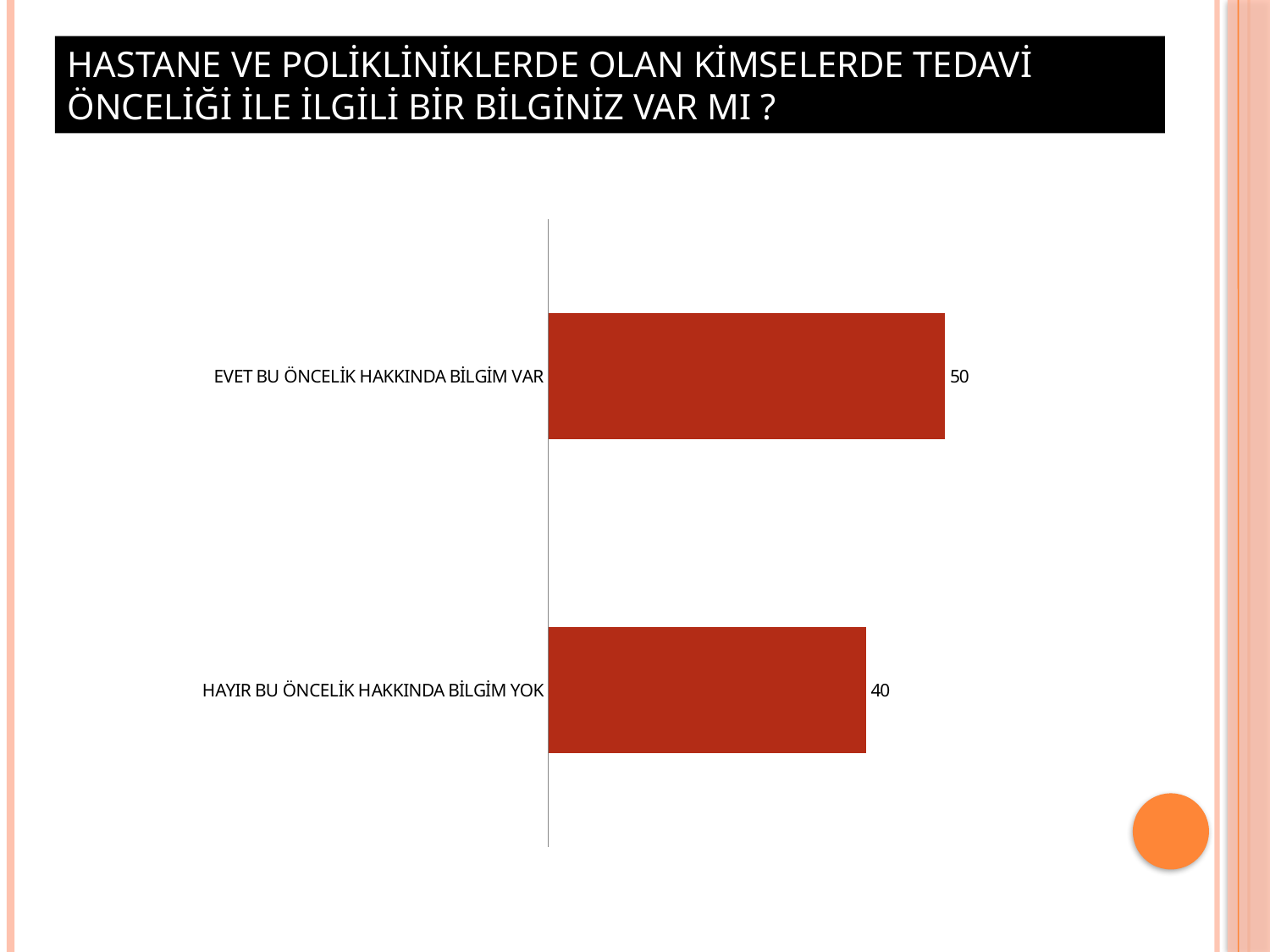
How many categories are shown in the chart? 2 What colour are the bars in the chart? Red Which category has the highest value? EVET BU ÖNCELİK HAKKINDA BİLGİM VAR What is the title of the slide? HASTANE VE POLİKLİNİKLERDE OLAN KİMSELERDE TEDAVİ ÖNCELİĞİ İLE İLGİLİ BİR BİLGİNİZ VAR MI ? What is the value for EVET BU ÖNCELİK HAKKINDA BİLGİM VAR? 50 What is the total of the two values shown in the chart? 90 Which category has the lowest value? HAYIR BU ÖNCELİK HAKKINDA BİLGİM YOK What kind of chart is shown on the slide? Bar chart What is the value for HAYIR BU ÖNCELİK HAKKINDA BİLGİM YOK? 40 What is the difference between the values for EVET BU ÖNCELİK HAKKINDA BİLGİM VAR and HAYIR BU ÖNCELİK HAKKINDA BİLGİM YOK? 10 Which is larger: the value for EVET BU ÖNCELİK HAKKINDA BİLGİM VAR or the value for HAYIR BU ÖNCELİK HAKKINDA BİLGİM YOK? EVET BU ÖNCELİK HAKKINDA BİLGİM VAR